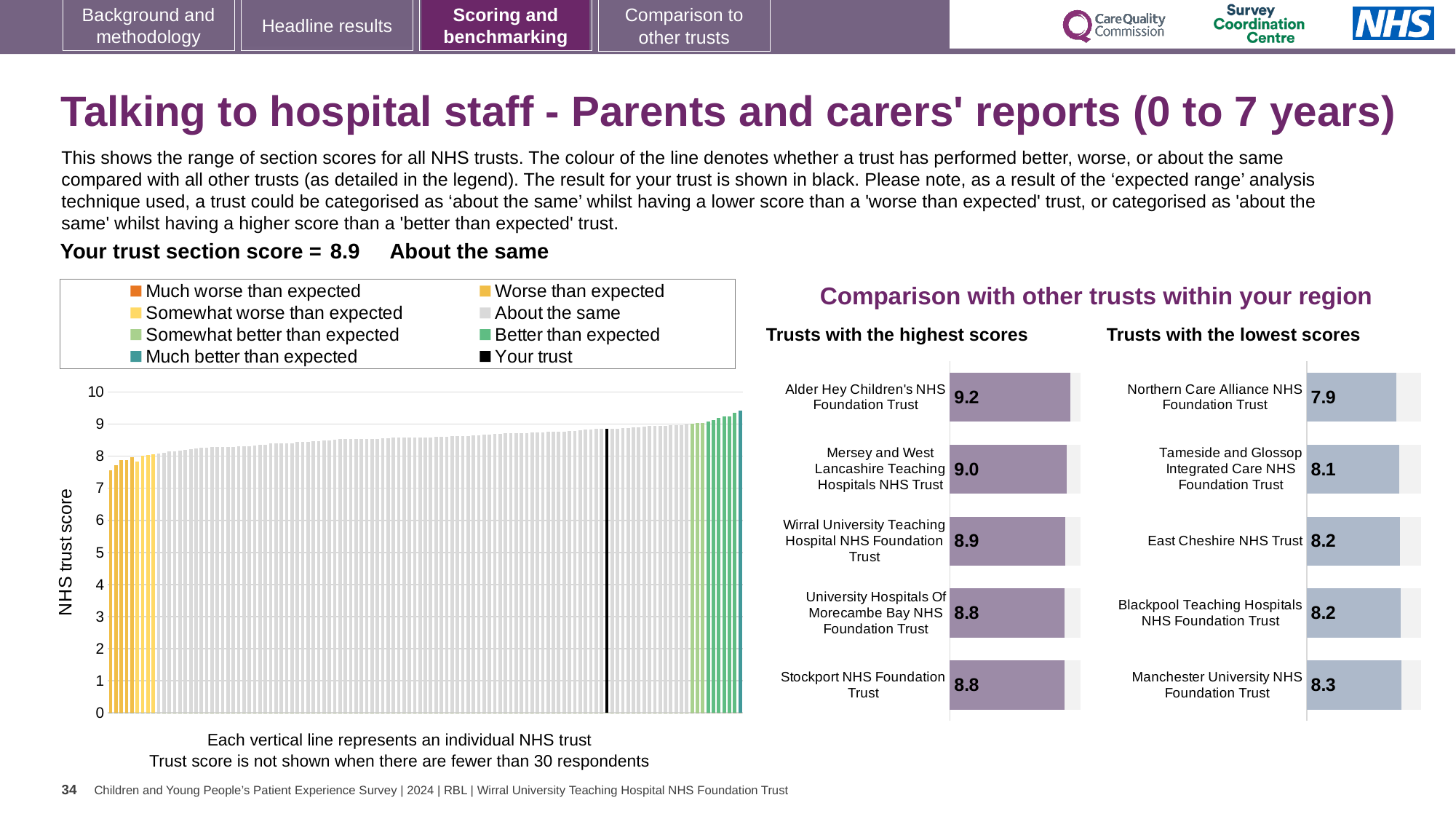
In the 'Trusts with the lowest scores' chart, which has the larger score: Tameside and Glossop Integrated Care NHS Foundation Trust or Manchester University NHS Foundation Trust? Manchester University NHS Foundation Trust In the large chart on the left, what colour represents 'Your trust' in the legend? Black In the 'Trusts with the highest scores' chart, what is the difference between the scores of Alder Hey Children's NHS Foundation Trust and Stockport NHS Foundation Trust? 0.4 In the 'Trusts with the highest scores' chart, which trust has the highest score? Alder Hey Children's NHS Foundation Trust What kind of chart is the large chart on the left showing NHS trust scores? Bar chart How many entries does the legend of the large chart on the left list? 8 In the 'Trusts with the highest scores' chart, what is the score for Alder Hey Children's NHS Foundation Trust? 9.2 In the 'Trusts with the highest scores' chart, what is the score for Mersey and West Lancashire Teaching Hospitals NHS Trust? 9.0 In the large chart on the left, do the trust scores rise or fall from left to right? Rise How many trusts are listed in the 'Trusts with the lowest scores' chart? 5 In the 'Trusts with the lowest scores' chart, what is the score for Northern Care Alliance NHS Foundation Trust? 7.9 In the 'Trusts with the lowest scores' chart, which trust has the lowest score? Northern Care Alliance NHS Foundation Trust